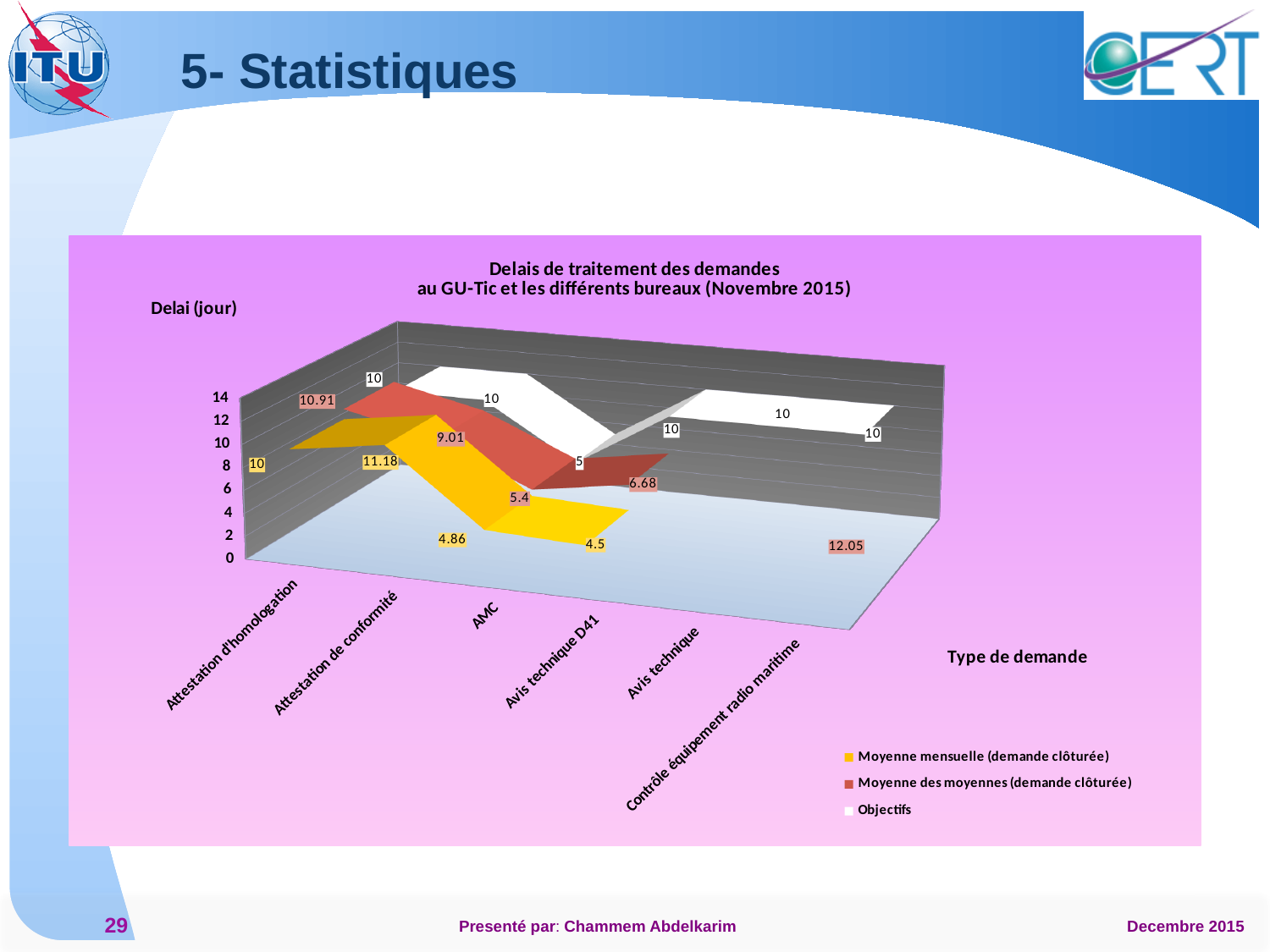
Which is larger for Moyenne mensuelle (demande clôturée): Attestation de conformité or AMC? Attestation de conformité How many series does the legend list? 3 What is the label of the vertical axis? Delai (jour) What kind of chart is shown on the slide? 3D line chart How many request types (categories) are shown on the x axis? 6 Which category has the highest Moyenne mensuelle (demande clôturée) value? Attestation de conformité What is the title of the chart? Delais de traitement des demandes au GU-Tic et les différents bureaux (Novembre 2015) What is the Moyenne des moyennes (demande clôturée) value for Attestation d'homologation? 10.91 What is the difference between the Moyenne mensuelle (demande clôturée) values for Attestation de conformité and AMC? 6.32 What is the Objectifs value for AMC? 5 What is the Moyenne mensuelle (demande clôturée) value for Attestation de conformité? 11.18